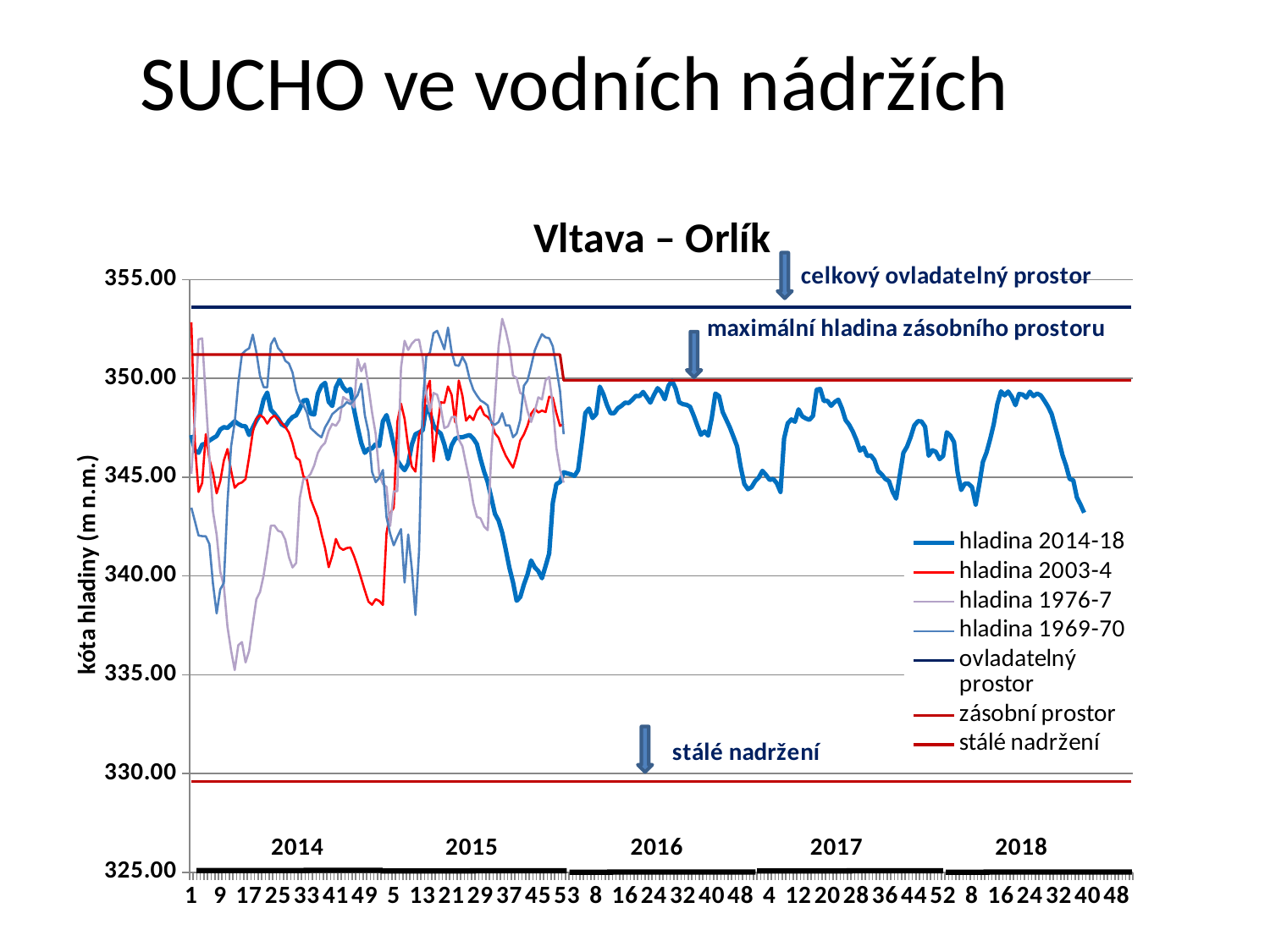
Which of the water level series drops to the lowest value on the chart? hladina 1976-7 Which series reaches a lower minimum in 2014: hladina 1976-7 or hladina 2003-4? hladina 1976-7 What kind of chart is shown on the slide? line chart What is the label of the vertical axis? kóta hladiny (m n.m.) Is the ovladatelný prostor line greater or less than 350.00? greater How many series does the chart legend list? 7 How many years are marked along the x axis of the chart? 5 Is the zásobní prostor line during 2014 greater or less than 350.00? greater Does the hladina 2014-18 series rise or fall over the final weeks of 2018? fall Is the lowest point of the hladina 1976-7 series greater or less than 340.00? less What is the title of the chart? Vltava – Orlík